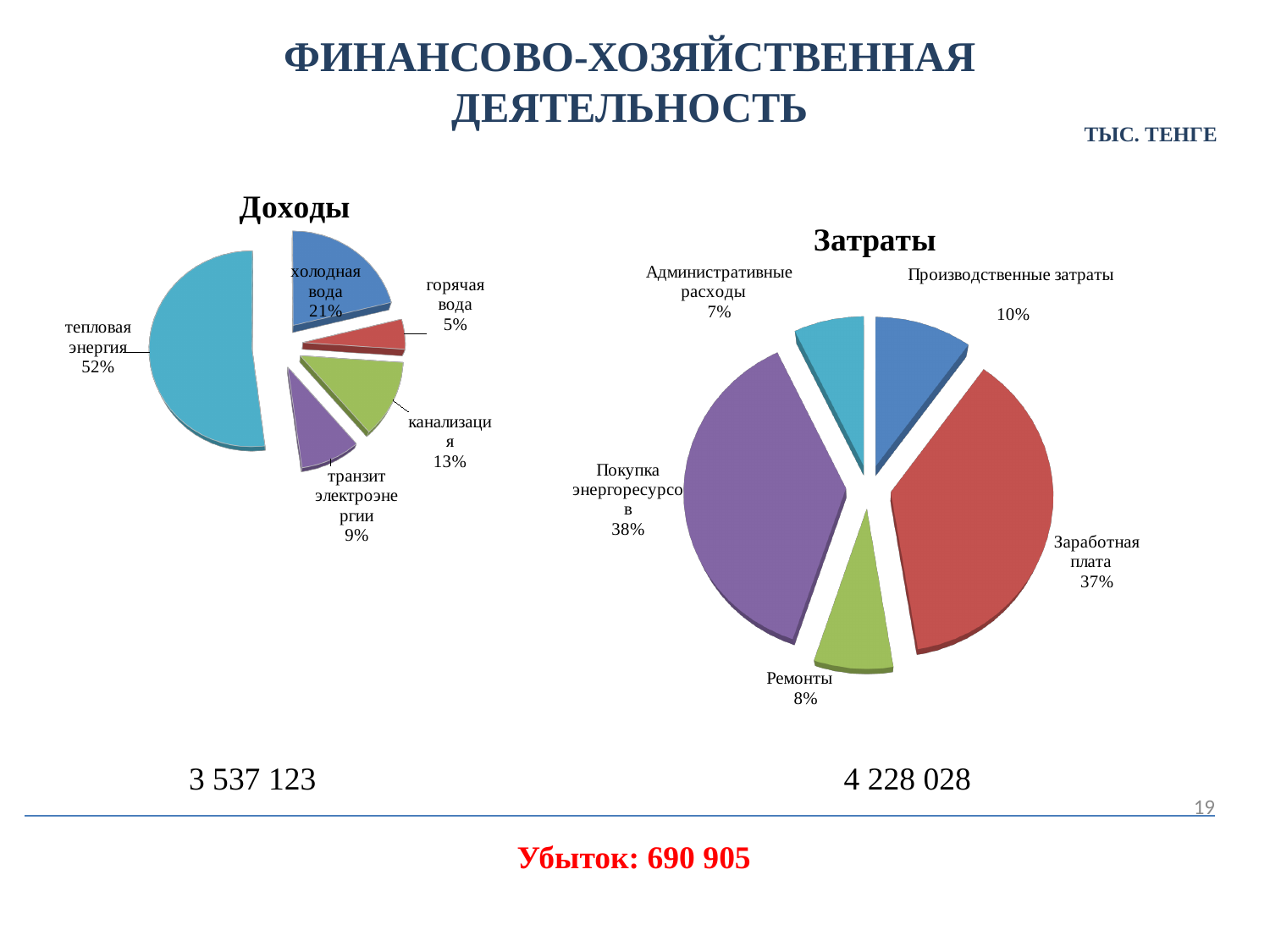
How many slices does the "Затраты" chart have? 5 In the "Доходы" chart, which category has the smallest share? горячая вода In the "Доходы" chart, what share does "тепловая энергия" have? 52% In the "Затраты" chart, what share does "Заработная плата" have? 37% In the "Доходы" chart, which category has the largest share? тепловая энергия In the "Доходы" chart, which is larger: "холодная вода" or "транзит электроэнергии"? холодная вода In the "Затраты" chart, what is the difference between the shares of "Заработная плата" and "Производственные затраты"? 27 percentage points In the "Затраты" chart, what share does "Ремонты" have? 8% How many slices does the "Доходы" chart have? 5 In the "Затраты" chart, what share does "Покупка энергоресурсов" have? 38% What kind of chart is the "Доходы" chart? pie chart In the "Доходы" chart, what is the difference between the shares of "холодная вода" and "канализация"? 8 percentage points